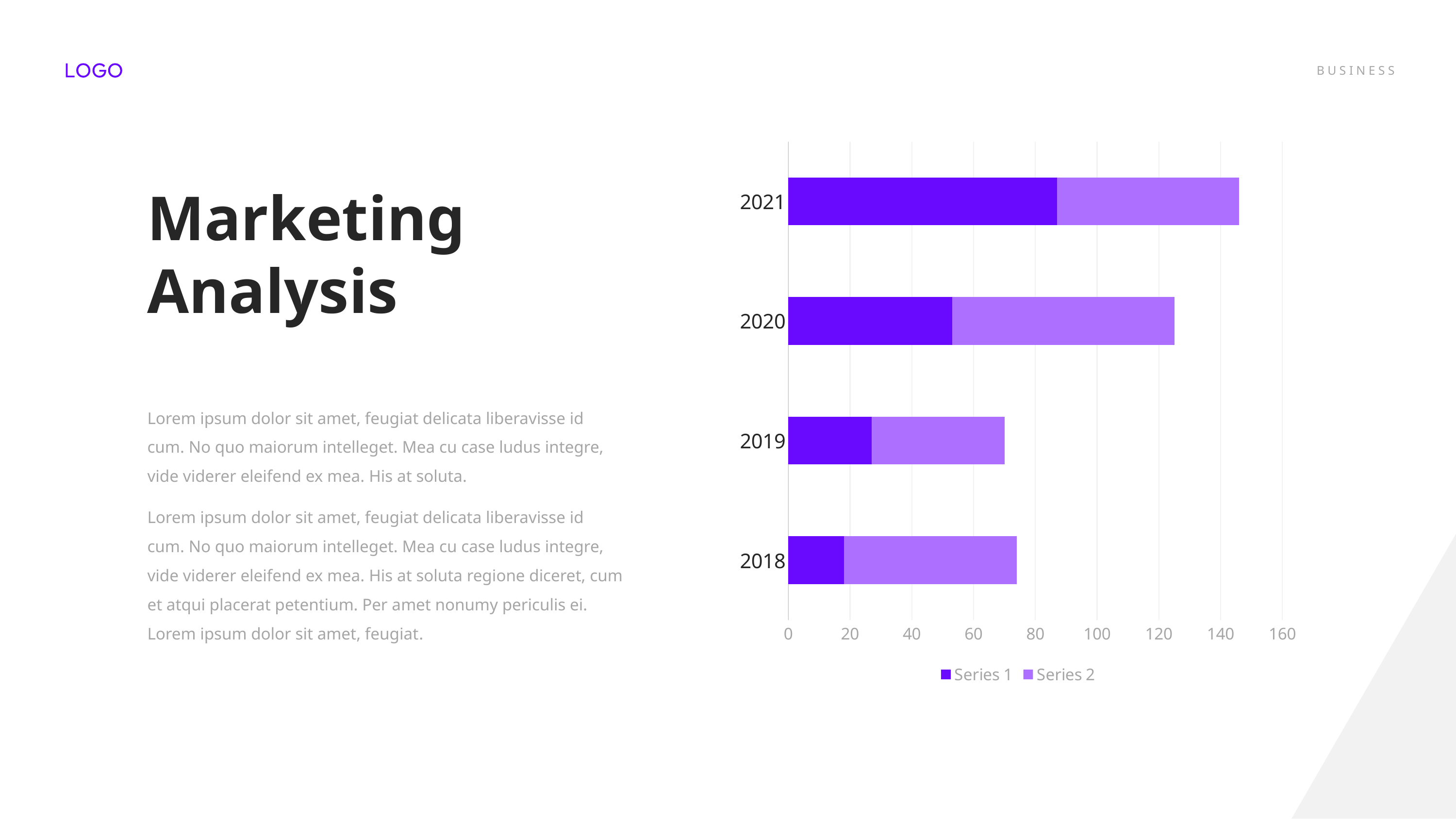
Is the Series 1 value for 2020 greater or less than 40? greater Is the Series 1 value for 2021 greater or less than 80? greater Is the total bar length for 2019 greater or less than 80? less How many series does the legend list? 2 Does the Series 1 value rise or fall from 2018 to 2021? rise Which year has the longest total bar? 2021 What kind of chart is shown on the slide? bar chart How many years are shown on the chart? 4 Which is larger, the Series 1 value for 2021 or for 2020? 2021 Which year has the smallest Series 1 value? 2018